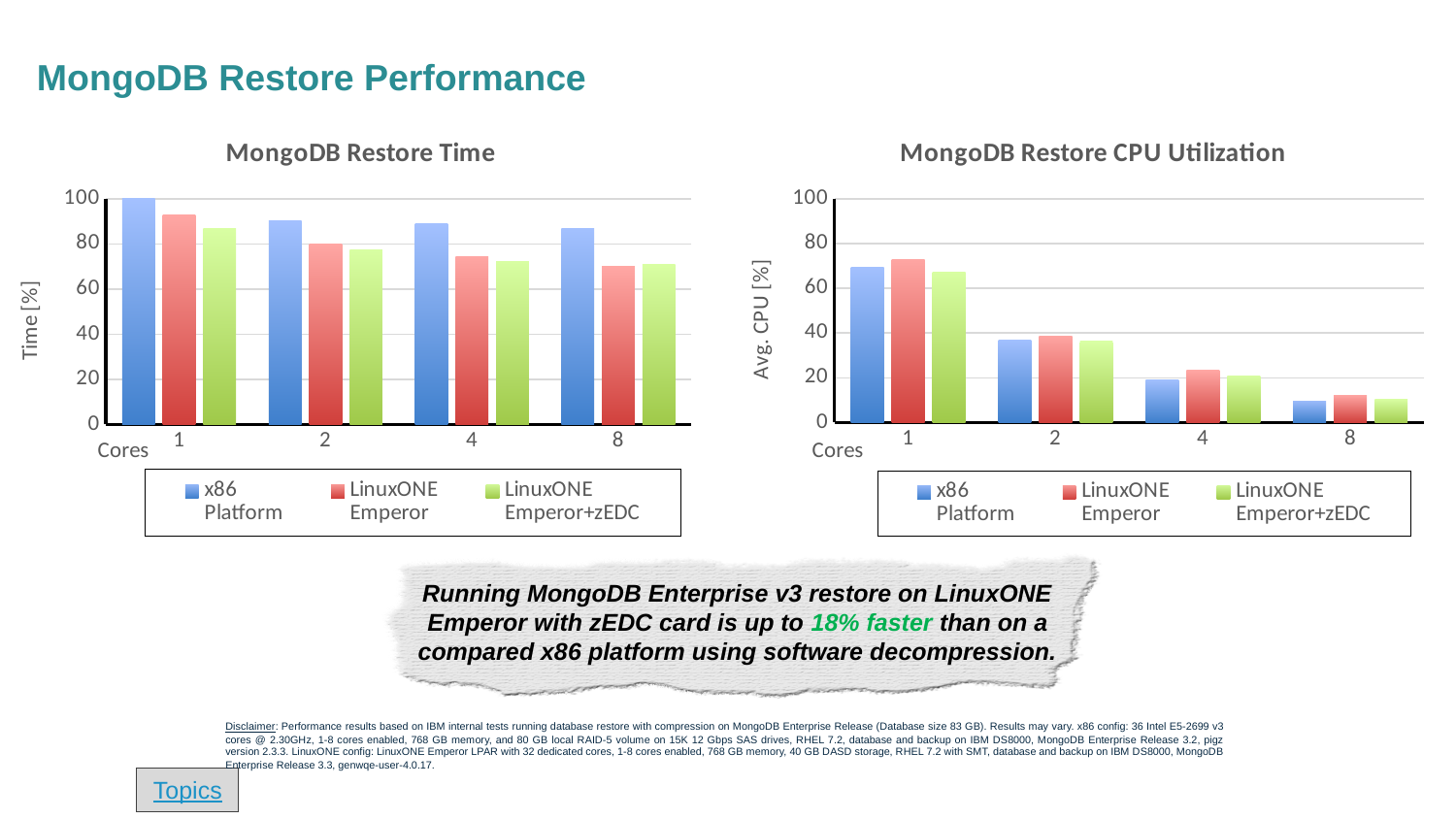
In the MongoDB Restore Time chart, what is the value for x86 Platform at 1 core? 100 What kind of chart is the MongoDB Restore Time chart? bar chart In the MongoDB Restore CPU Utilization chart, at which core count is the x86 Platform value highest? 1 In the MongoDB Restore Time chart, is the value for LinuxONE Emperor at 8 cores greater or less than 80? less In the MongoDB Restore CPU Utilization chart, do the x86 Platform values rise or fall as the number of cores increases? fall In the MongoDB Restore CPU Utilization chart, is the value for LinuxONE Emperor at 8 cores greater or less than 20? less How many core-count categories are shown on the x axis of the MongoDB Restore Time chart? 4 In the MongoDB Restore Time chart, at 2 cores, which is larger: x86 Platform or LinuxONE Emperor? x86 Platform In the MongoDB Restore CPU Utilization chart, is the value for x86 Platform at 1 core greater or less than 60? greater In the MongoDB Restore CPU Utilization chart, at 4 cores, which series has the highest value? LinuxONE Emperor What is the y-axis label of the MongoDB Restore Time chart? Time [%] How many series does the legend of the MongoDB Restore CPU Utilization chart list? 3